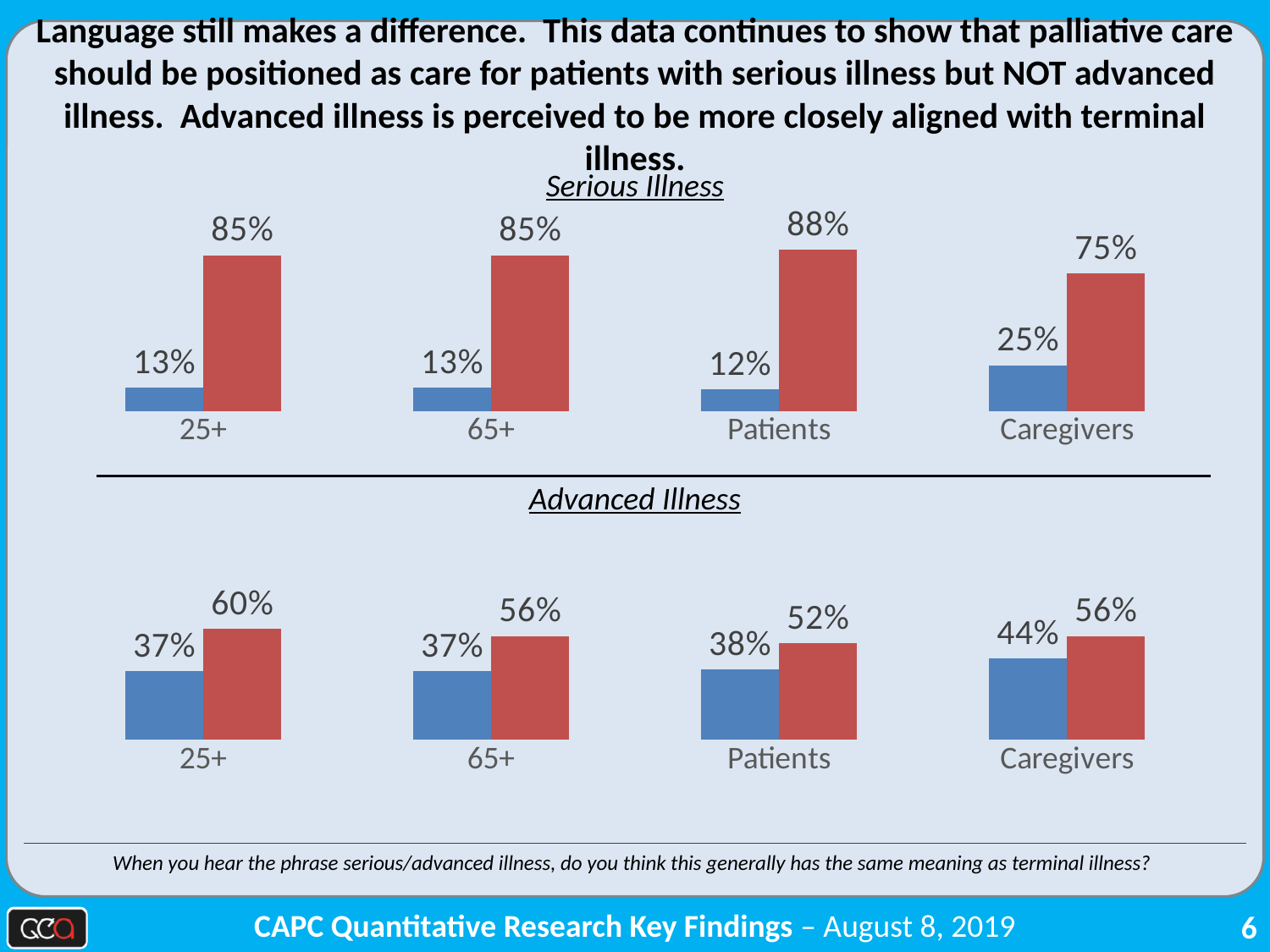
In the Serious Illness chart, what is the difference between the red and blue bar values for 25+? 72 percentage points In the Serious Illness chart, which category has the highest red bar value? Patients In the Advanced Illness chart, what is the value of the red bar for 25+? 60% In the Serious Illness chart, what is the value of the red bar for Patients? 88% In the Advanced Illness chart, what is the difference between the red and blue bar values for Caregivers? 12 percentage points How many categories are shown along the x axis of the Advanced Illness chart? 4 Which is larger: the red bar for Caregivers in the Serious Illness chart or the red bar for Caregivers in the Advanced Illness chart? Serious Illness In the Serious Illness chart, which category has the lowest red bar value? Caregivers In the Advanced Illness chart, which category has the lowest red bar value? Patients What type of chart is used for the Serious Illness data? Bar chart In the Serious Illness chart, what is the value of the blue bar for Caregivers? 25% In the Advanced Illness chart, what is the value of the blue bar for Caregivers? 44%